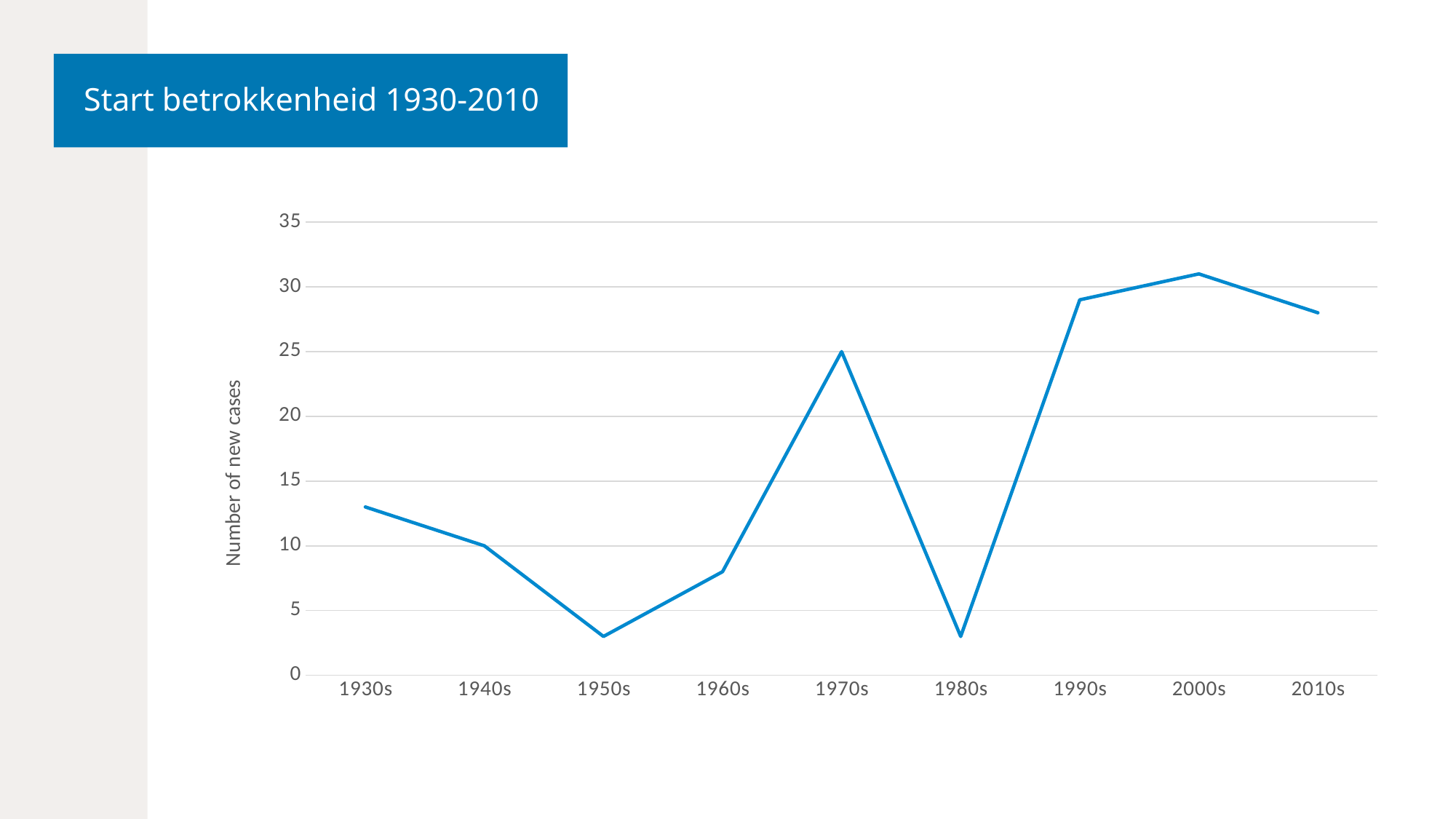
Is the value for the 1990s greater or less than 25? greater Is the value for the 2010s greater or less than 25? greater Which is larger, the value for the 1970s or the value for the 1980s? 1970s What is the label of the vertical axis? Number of new cases Which decade has the highest number of new cases? 2000s Is the value for the 1950s greater or less than 5? less Do the values rise or fall from the 1930s to the 1950s? fall What is the number of new cases for the 1940s? 10 What type of chart is shown on the slide? line chart How many decades are plotted along the x axis? 9 What is the number of new cases for the 1970s? 25